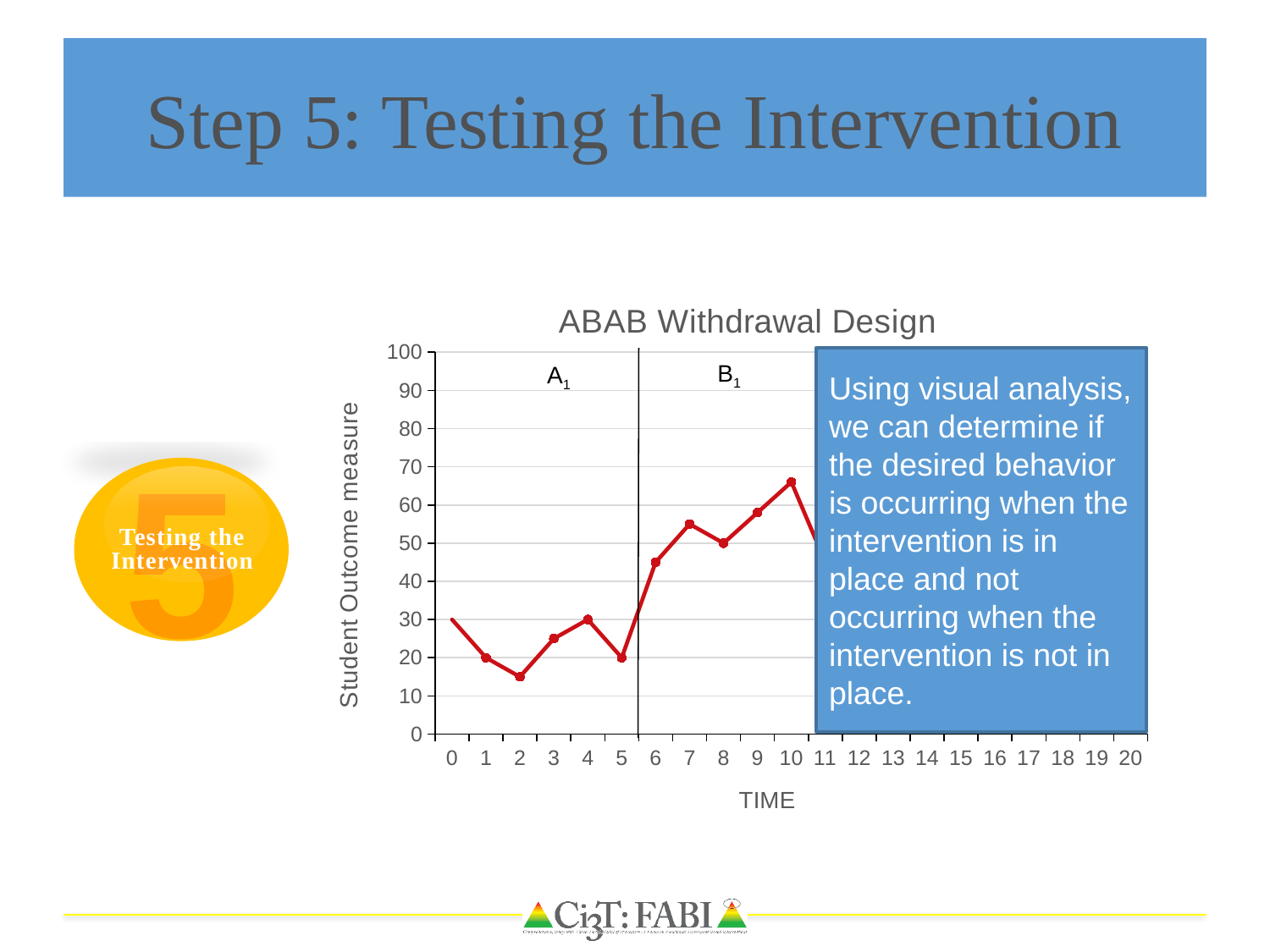
What is the Student Outcome measure at time 8? 50 What is the Student Outcome measure at time 1? 20 Do the values generally rise or fall from time 5 to time 10? rise Is the value at time 10 greater or less than 60? greater Is the value at time 6 greater or less than 40? greater Is the value at time 2 greater or less than 20? less What is the label on the y axis of the chart? Student Outcome measure What is the Student Outcome measure at time 0? 30 What kind of chart is shown on the slide? line chart What is the title of the chart? ABAB Withdrawal Design Which has the larger Student Outcome measure, time 5 or time 6? time 6 At which time point is the Student Outcome measure lowest? 2